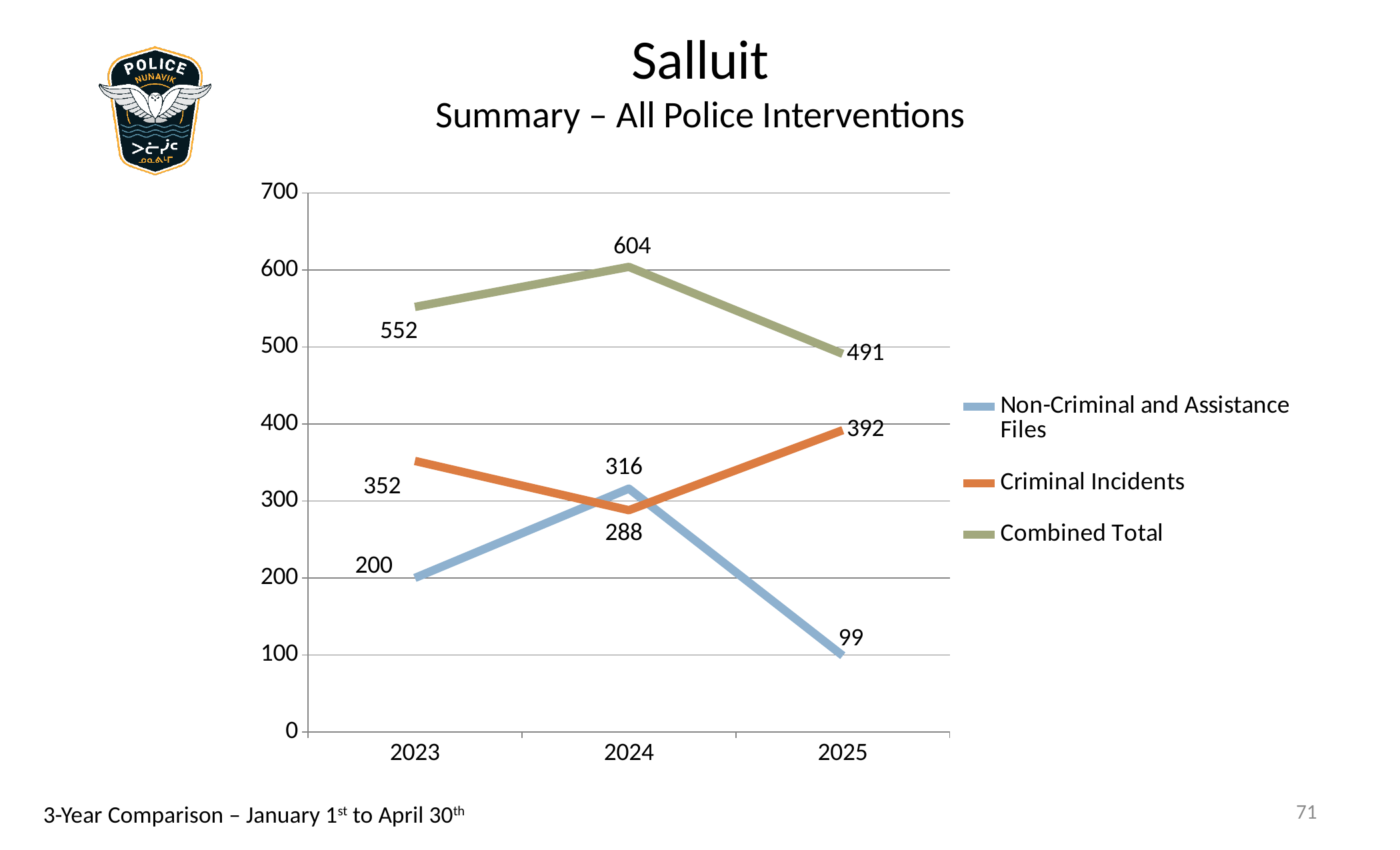
In which year is the Combined Total highest? 2024 What is the value for Criminal Incidents in 2025? 392 What is the value for Non-Criminal and Assistance Files in 2024? 316 How many series does the legend list? 3 Is the value for Criminal Incidents in 2024 greater or less than 300? less How many years are shown on the x axis? 3 What kind of chart is shown on the slide? line chart Which is larger in 2024: Non-Criminal and Assistance Files or Criminal Incidents? Non-Criminal and Assistance Files In which year is the value for Non-Criminal and Assistance Files lowest? 2025 Does the Criminal Incidents series rise or fall from 2024 to 2025? rise What is the Combined Total for 2023? 552 What is the difference between the Combined Total in 2024 and in 2025? 113